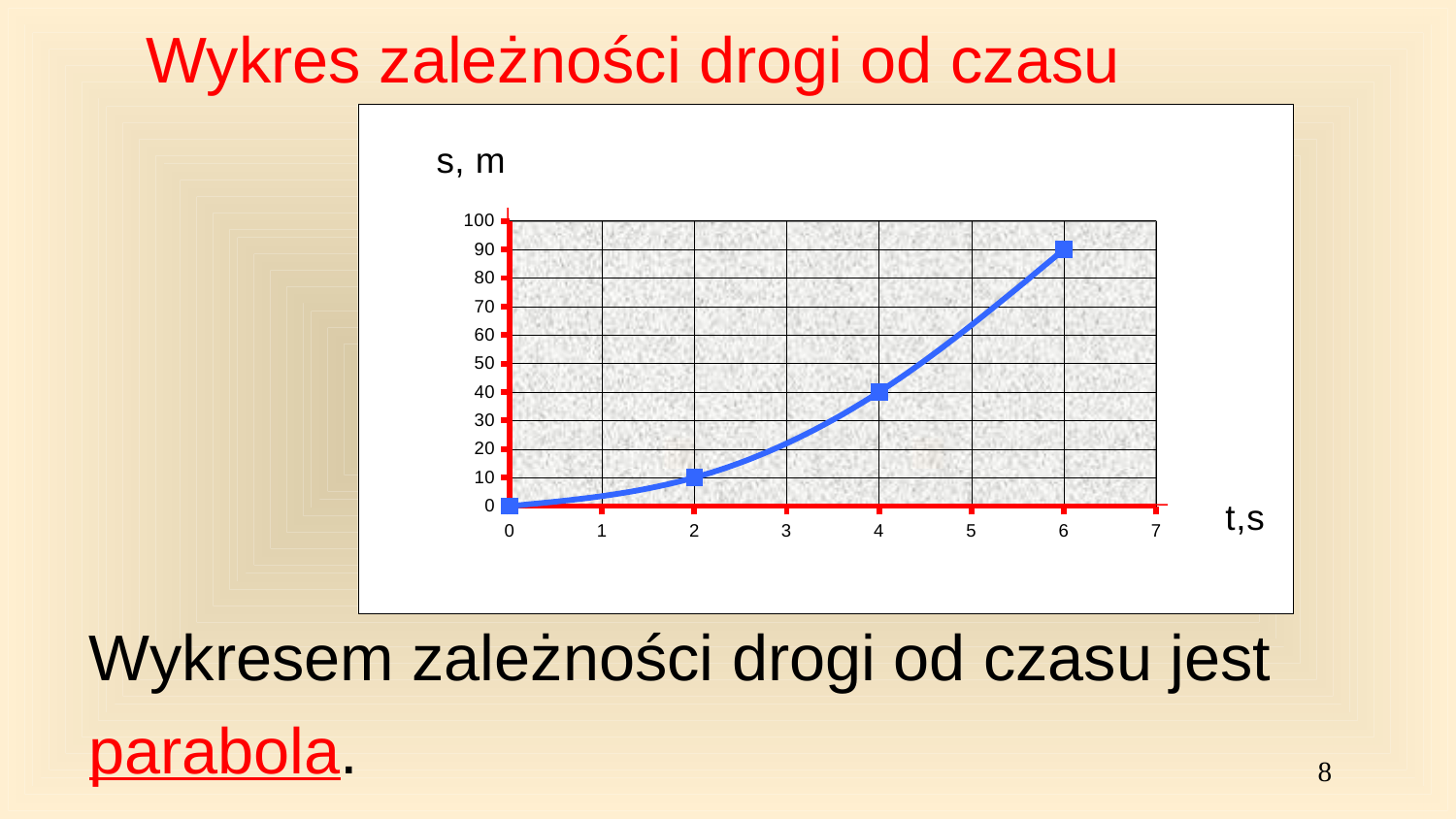
What is the difference between s at t = 6 s and s at t = 4 s? 50 What is the label of the vertical axis? s, m What is the value of s at t = 4 s? 40 What is the value of s at t = 2 s? 10 What is the value of s at t = 6 s? 90 At which value of t is s the lowest? 0 Which is larger: s at t = 4 s or s at t = 2 s? s at t = 4 s At which value of t is s the highest? 6 What is the value of s at t = 0 s? 0 Does s rise or fall as t increases? rise What kind of chart is shown on the slide? line chart How many data points are plotted on the chart? 4